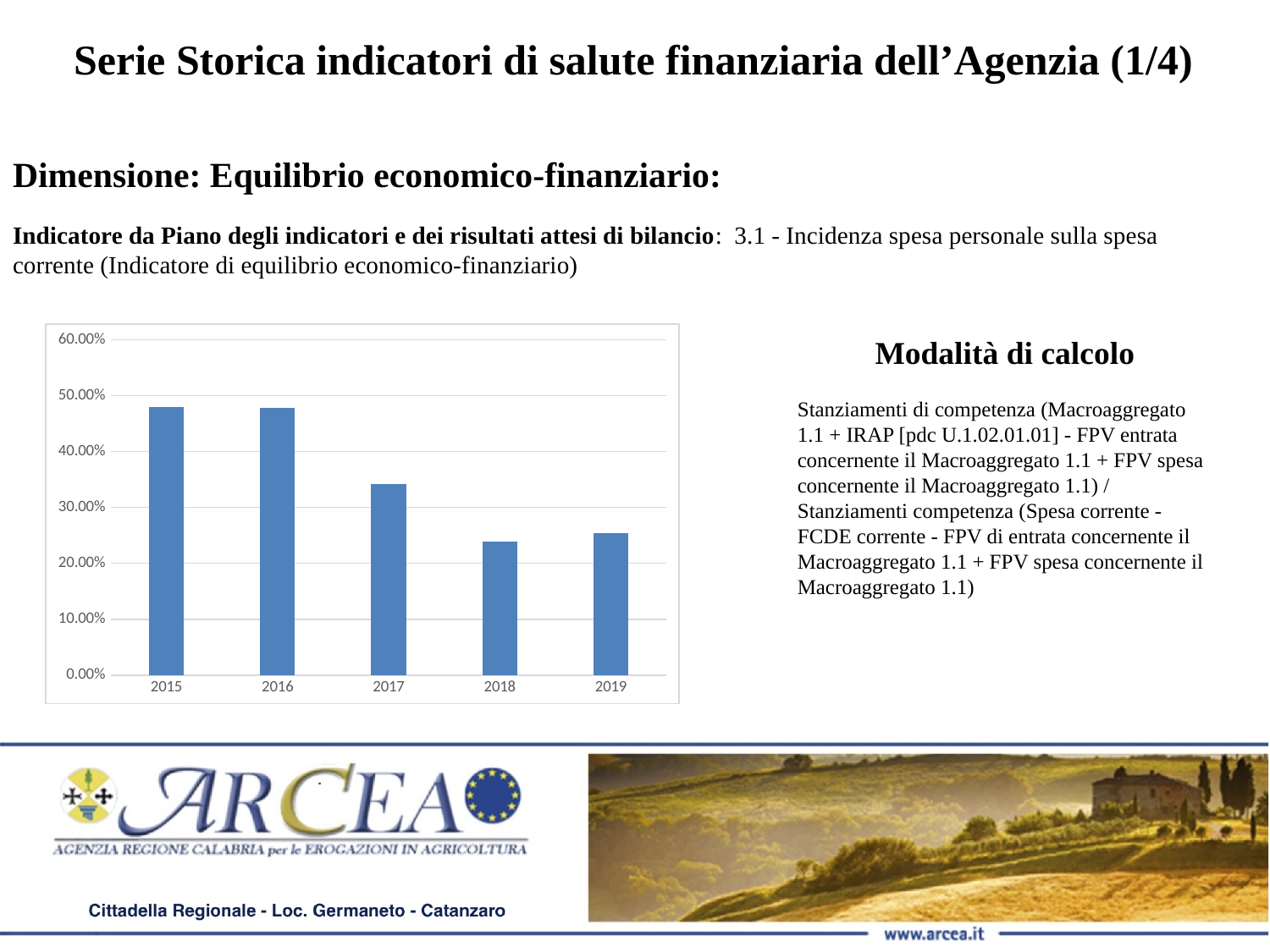
Do the values rise or fall from 2015 to 2018? fall Is the value for 2015 greater or less than 40.00%? greater Which is larger, the value for 2015 or the value for 2017? 2015 What kind of chart is shown on the slide? bar chart Is the value for 2018 greater or less than 20.00%? greater Is the value for 2016 greater or less than 50.00%? less Which is larger, the value for 2016 or the value for 2018? 2016 How many years are plotted on the x axis of the chart? 5 What is the highest value shown on the y axis of the chart? 60.00%